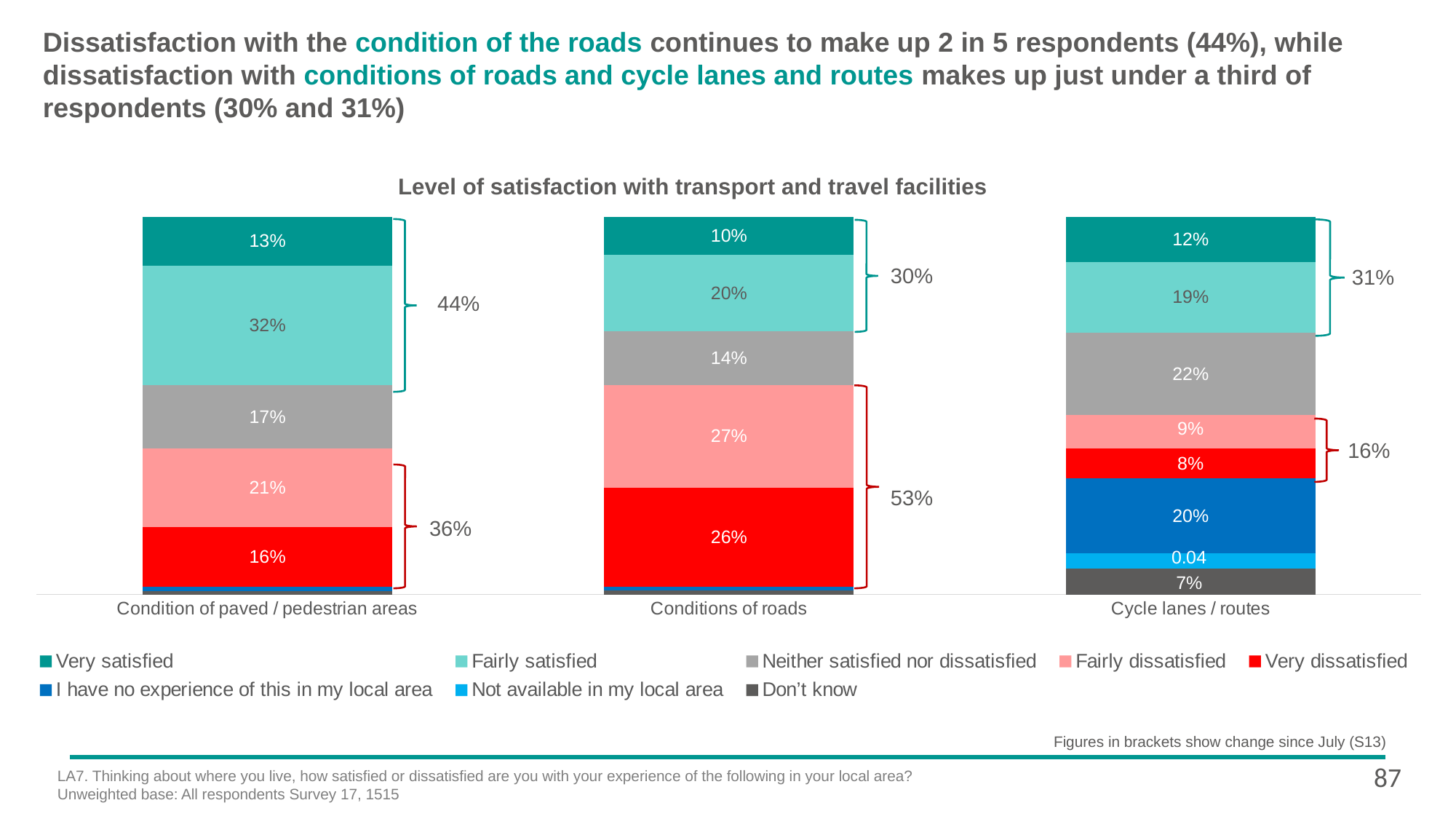
How many categories are shown on the x axis? 3 What is the 'Neither satisfied nor dissatisfied' value for Cycle lanes / routes? 22% What is the 'Very dissatisfied' value for Conditions of roads? 26% What is the 'I have no experience of this in my local area' value for Cycle lanes / routes? 20% What kind of chart is shown on the slide? Stacked bar chart Which category has the lowest 'Fairly dissatisfied' value? Cycle lanes / routes What is the title of the chart? Level of satisfaction with transport and travel facilities How many series does the legend list? 8 Which category has the highest 'Very dissatisfied' value? Conditions of roads What is the difference between the 'Fairly dissatisfied' values for Conditions of roads and Cycle lanes / routes? 18% What is the 'Fairly satisfied' value for Condition of paved / pedestrian areas? 32% Which is larger: the 'Very satisfied' value for Condition of paved / pedestrian areas or for Conditions of roads? Condition of paved / pedestrian areas